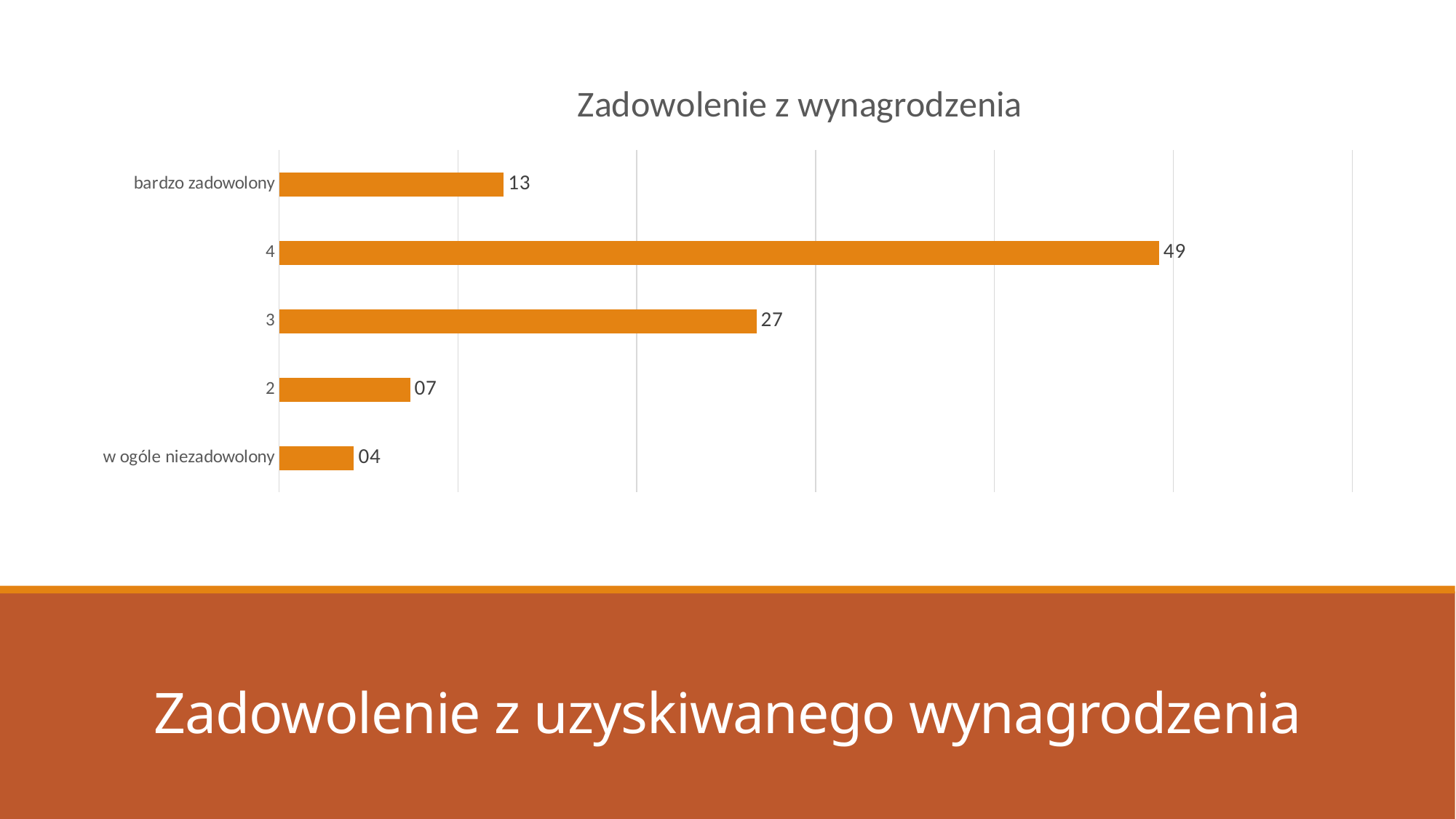
What is the difference between the values for category "4" and category "3"? 22 Which is larger, the value for "bardzo zadowolony" or the value for category "2"? bardzo zadowolony What is the value for category "3"? 27 What kind of chart is shown on the slide? bar chart What is the value for category "4"? 49 Which category has the highest value? 4 What is the value for "bardzo zadowolony"? 13 What is the value for "w ogóle niezadowolony"? 04 How many categories are shown in the chart? 5 Which category has the lowest value? w ogóle niezadowolony What is the value for category "2"? 07 What is the title of the chart? Zadowolenie z wynagrodzenia